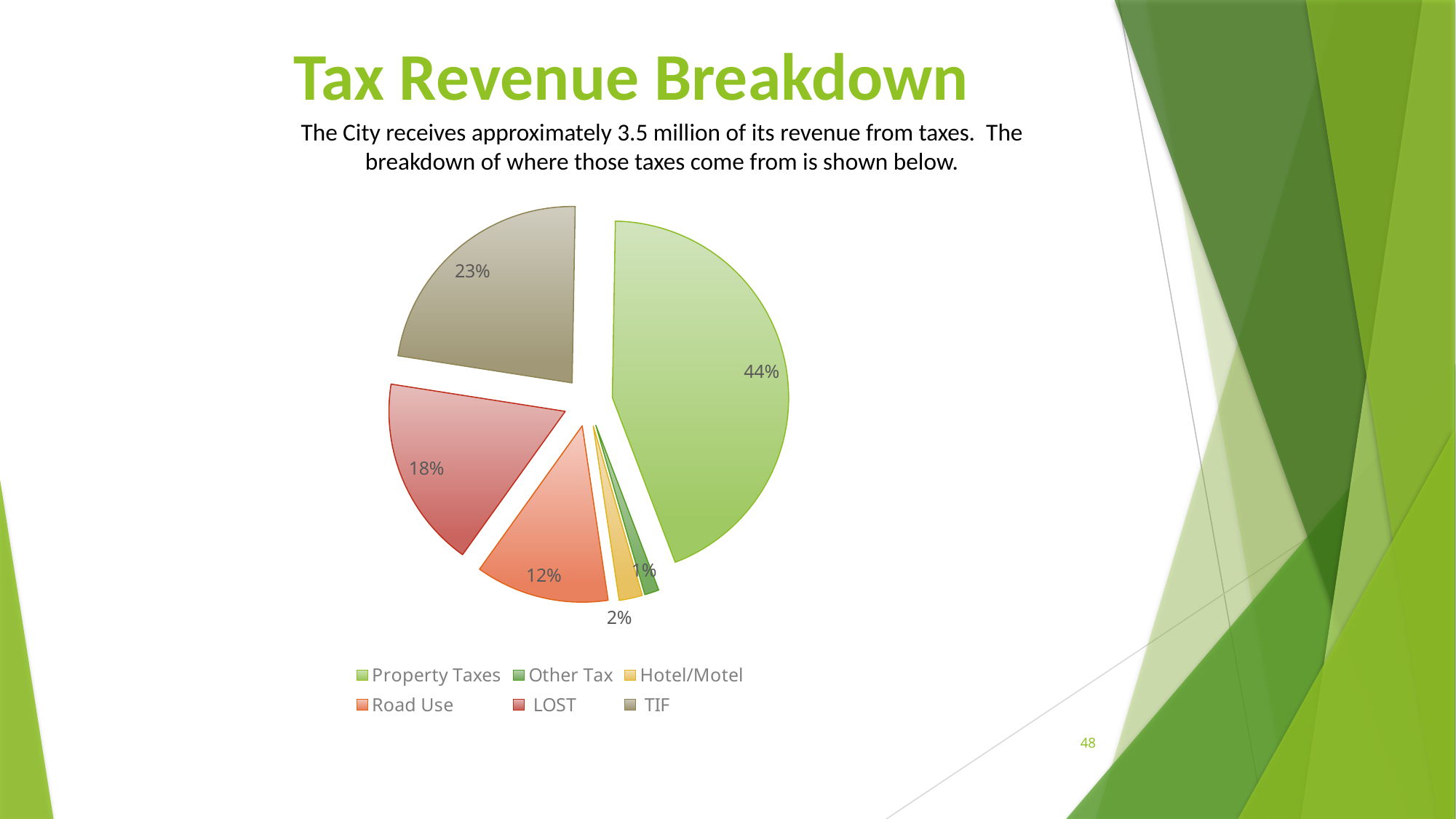
What share of tax revenue comes from Road Use? 12% How many categories does the pie chart show? 6 Which category has the smallest share of tax revenue? Other Tax What share of tax revenue comes from LOST? 18% Which category has the largest share of tax revenue? Property Taxes Which is larger, the LOST share or the Road Use share? LOST What kind of chart is shown on the slide? Pie chart What share of tax revenue comes from Hotel/Motel? 2% What is the difference in percentage points between the Property Taxes share and the TIF share? 21 What share of tax revenue comes from Property Taxes? 44% What share of tax revenue comes from TIF? 23% What is the title of the slide containing the chart? Tax Revenue Breakdown